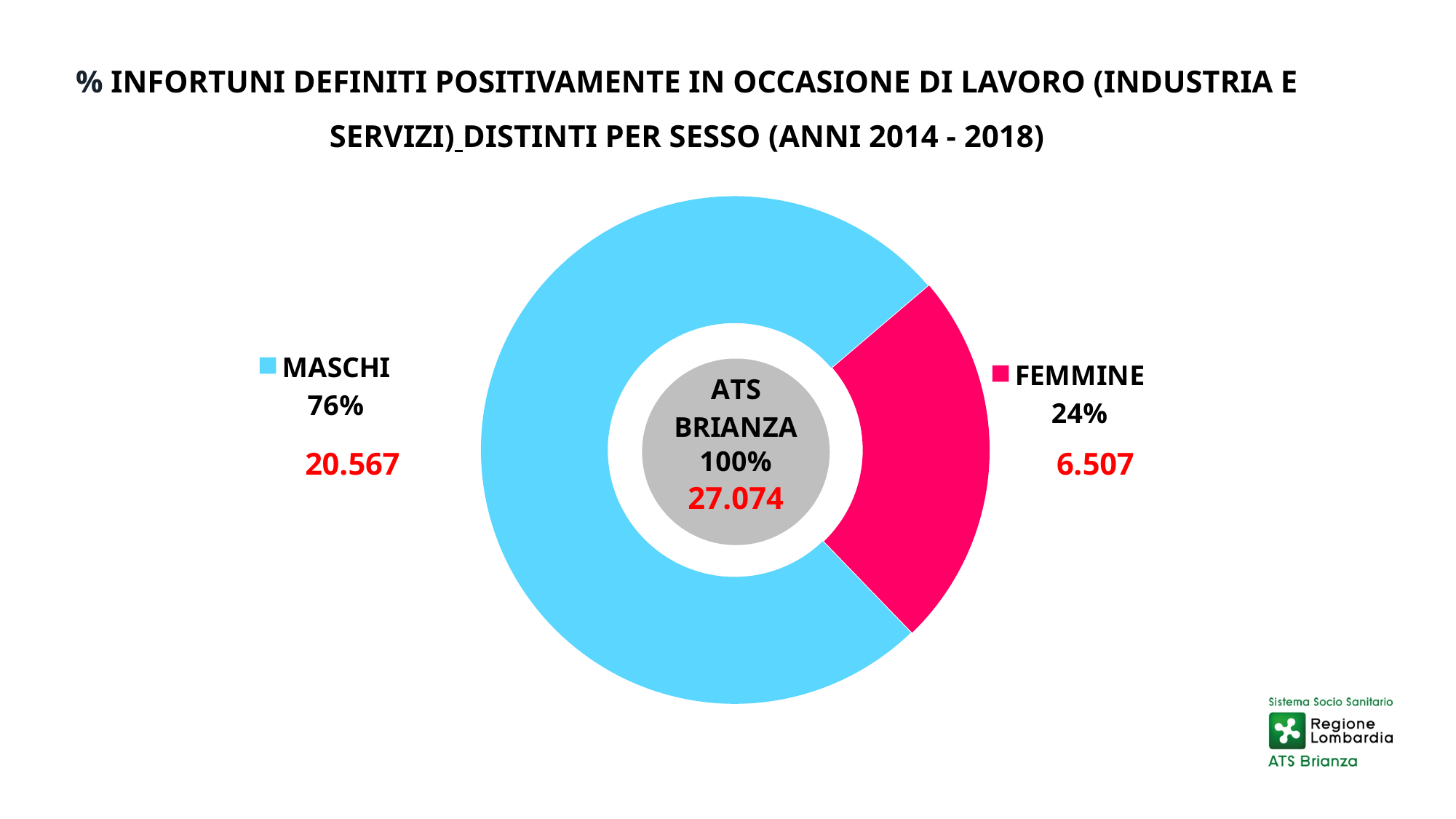
What percentage share does the MASCHI slice have? 76% What is the number shown for MASCHI? 20.567 What is the number shown for FEMMINE? 6.507 What total is shown in the centre of the chart for ATS BRIANZA? 27.074 What is the difference in percentage points between the MASCHI and FEMMINE shares? 52 What kind of chart is shown on the slide? Pie chart (doughnut) Which category has the largest slice? MASCHI How many categories does the chart show? 2 What colour is the FEMMINE slice? Pink/magenta Which is larger, the value for MASCHI or the value for FEMMINE? MASCHI Which category has the smallest slice? FEMMINE What percentage share does the FEMMINE slice have? 24%